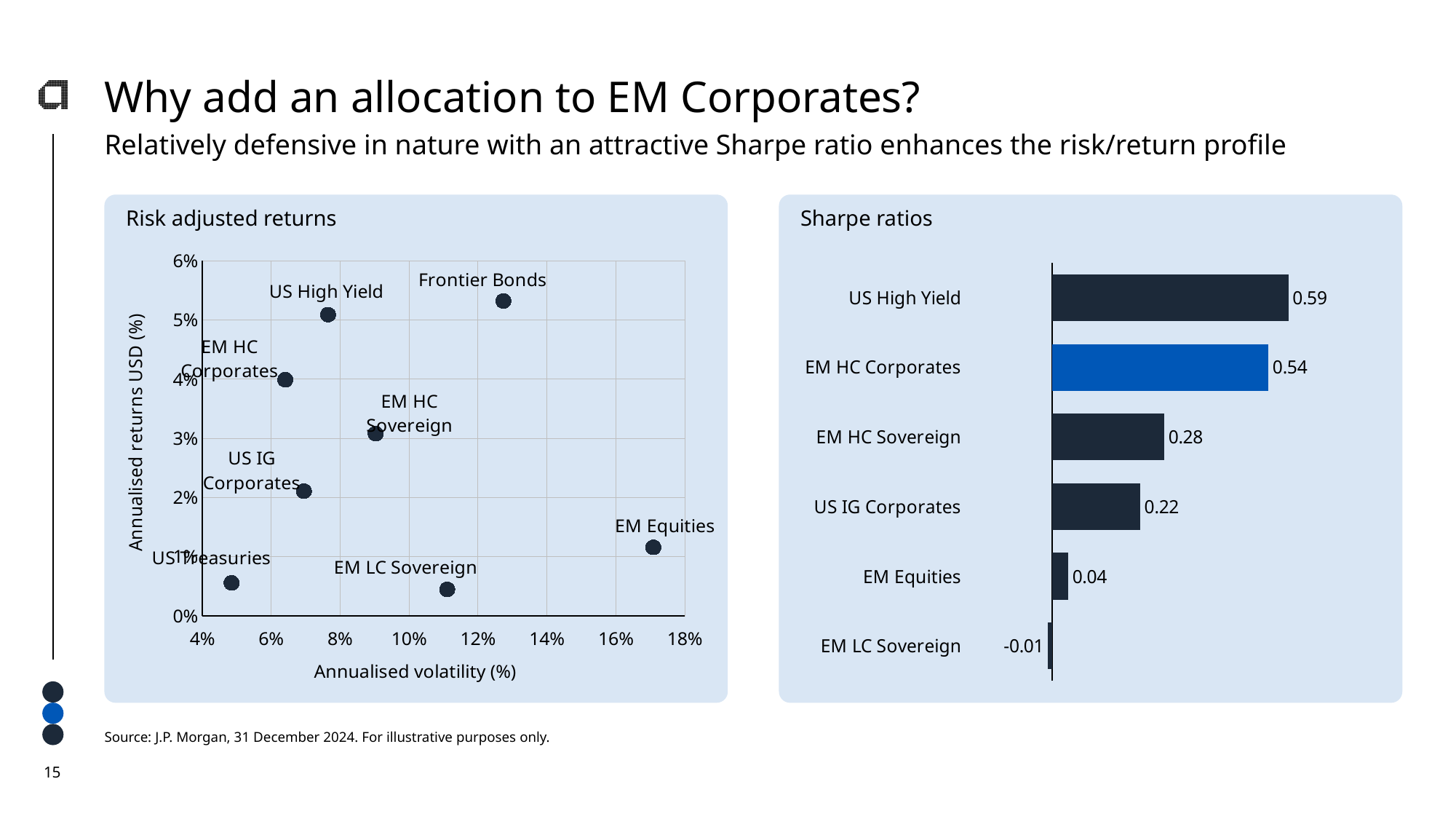
What kind of chart is the Sharpe ratios chart? Bar chart How many categories are shown in the Sharpe ratios chart? 6 In the Risk adjusted returns chart, is the annualised volatility for EM Equities greater or less than 16%? greater In the Risk adjusted returns chart, how many data points are plotted? 8 In the Sharpe ratios chart, which has a higher Sharpe ratio, EM HC Sovereign or US IG Corporates? EM HC Sovereign In the Risk adjusted returns chart, which asset class has the highest annualised volatility? EM Equities In the Sharpe ratios chart, which category has the highest Sharpe ratio? US High Yield In the Sharpe ratios chart, what is the Sharpe ratio for EM LC Sovereign? -0.01 In the Sharpe ratios chart, which bar is highlighted in a different colour (blue) from the others? EM HC Corporates In the Sharpe ratios chart, what is the difference between the Sharpe ratios of US High Yield and EM HC Corporates? 0.05 In the Sharpe ratios chart, what is the Sharpe ratio for EM HC Corporates? 0.54 In the Sharpe ratios chart, which category has the lowest Sharpe ratio? EM LC Sovereign